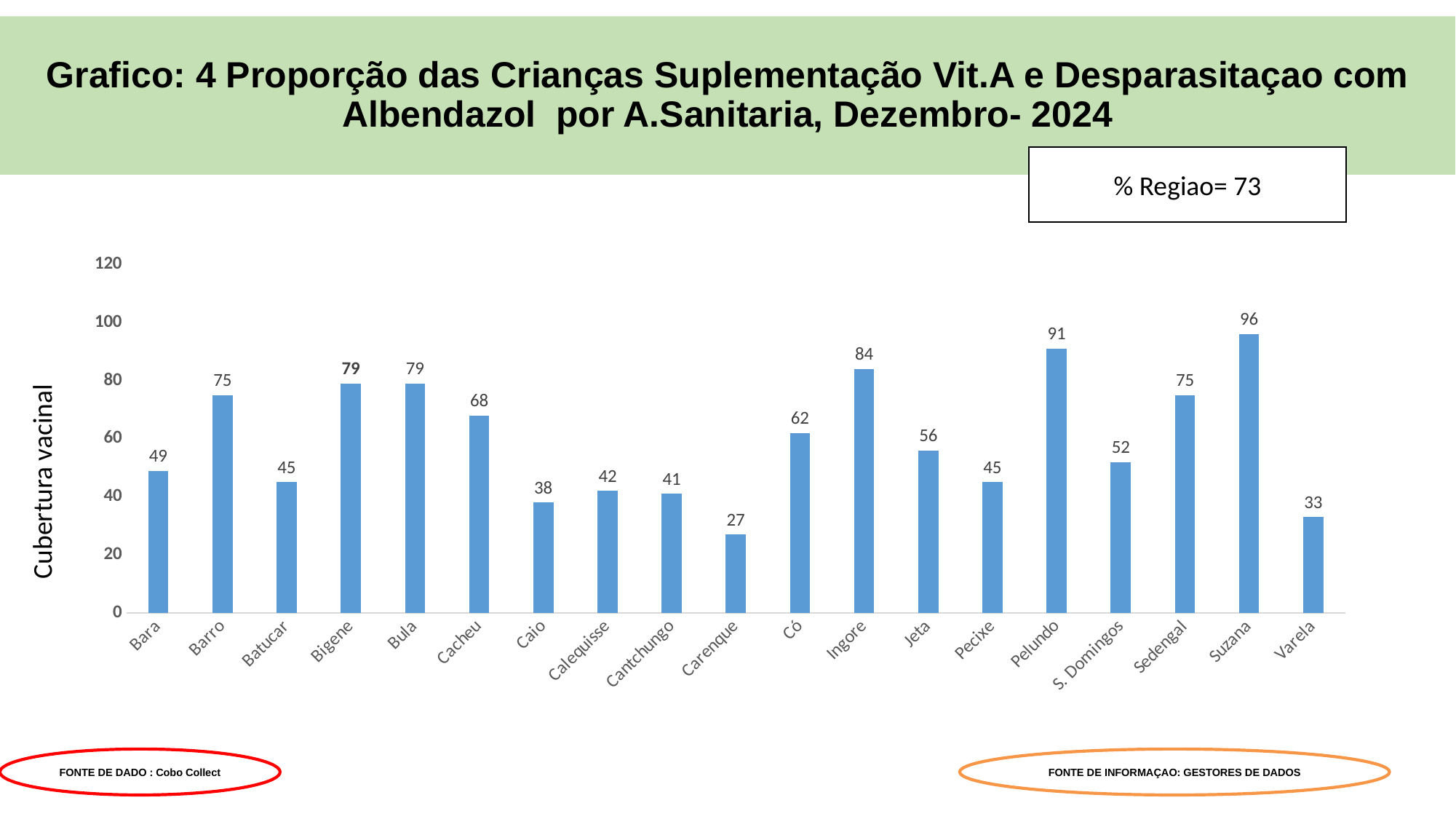
What is the value for Carenque? 27 Which is larger, the value for Cacheu or the value for Có? Cacheu What is the value for S. Domingos? 52 What kind of chart is shown on the slide? Bar chart How many categories are shown on the x axis? 19 What is the value for Pelundo? 91 Which category has the highest value? Suzana What is the value for Ingore? 84 What regional percentage is shown in the box above the chart? % Regiao= 73 Which category has the lowest value? Carenque What is the y-axis title of the chart? Cubertura vacinal What is the difference between the values for Suzana and Varela? 63